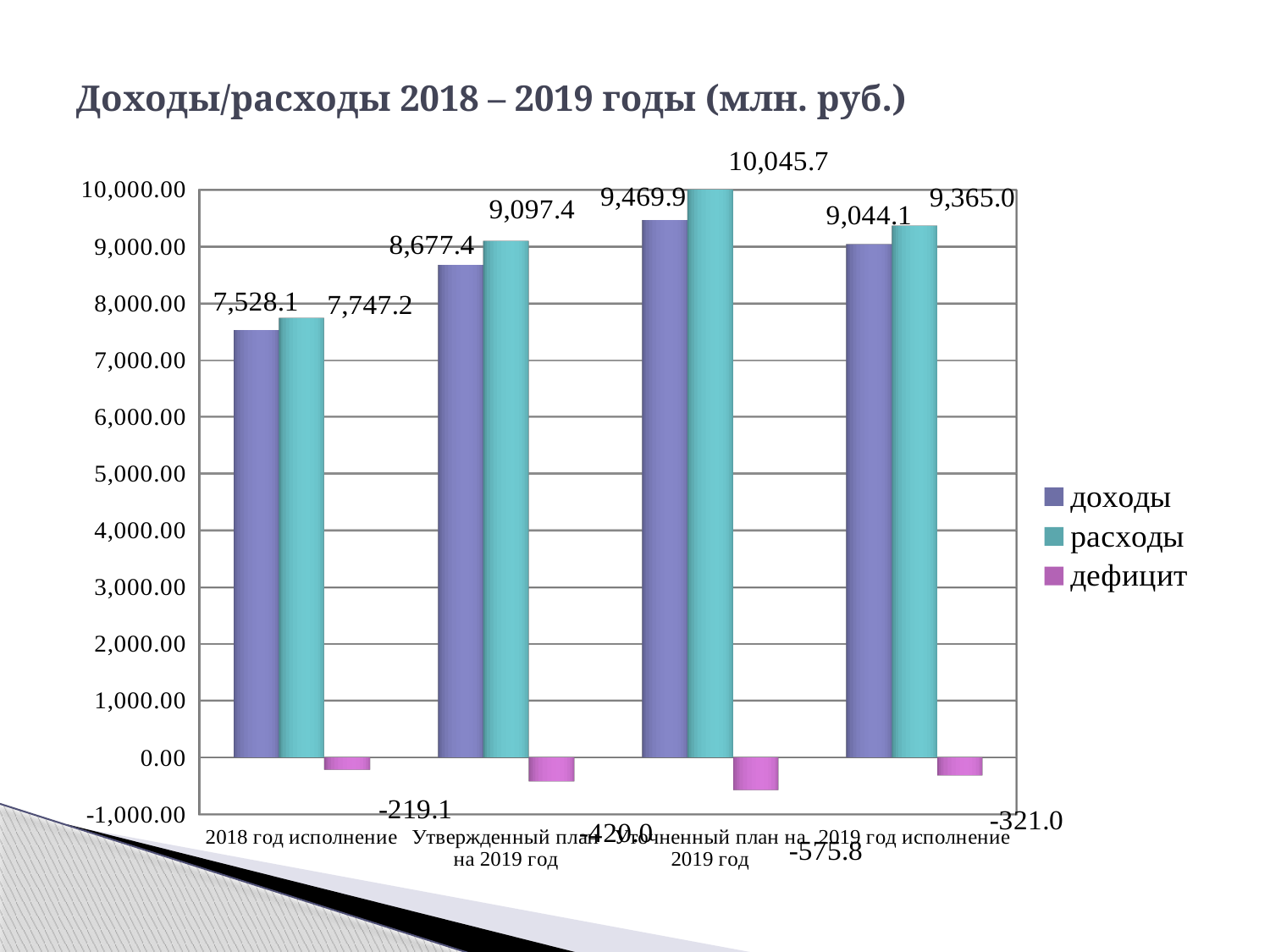
What is the title of the chart? Доходы/расходы 2018 – 2019 годы (млн. руб.) What is the value of расходы for Уточненный план на 2019 год? 10,045.7 What kind of chart is shown on the slide? bar chart What is the value of дефицит for 2019 год исполнение? -321.0 Which is larger: доходы for 2019 год исполнение or доходы for Уточненный план на 2019 год? доходы for Уточненный план на 2019 год How many categories are shown on the x axis? 4 Which category has the lowest value of доходы? 2018 год исполнение What is the value of расходы for 2019 год исполнение? 9,365.0 What is the value of доходы for 2018 год исполнение? 7,528.1 How many series does the legend list? 3 What is the difference between расходы and доходы for Утвержденный план на 2019 год? 420.0 Which category has the highest value of расходы? Уточненный план на 2019 год